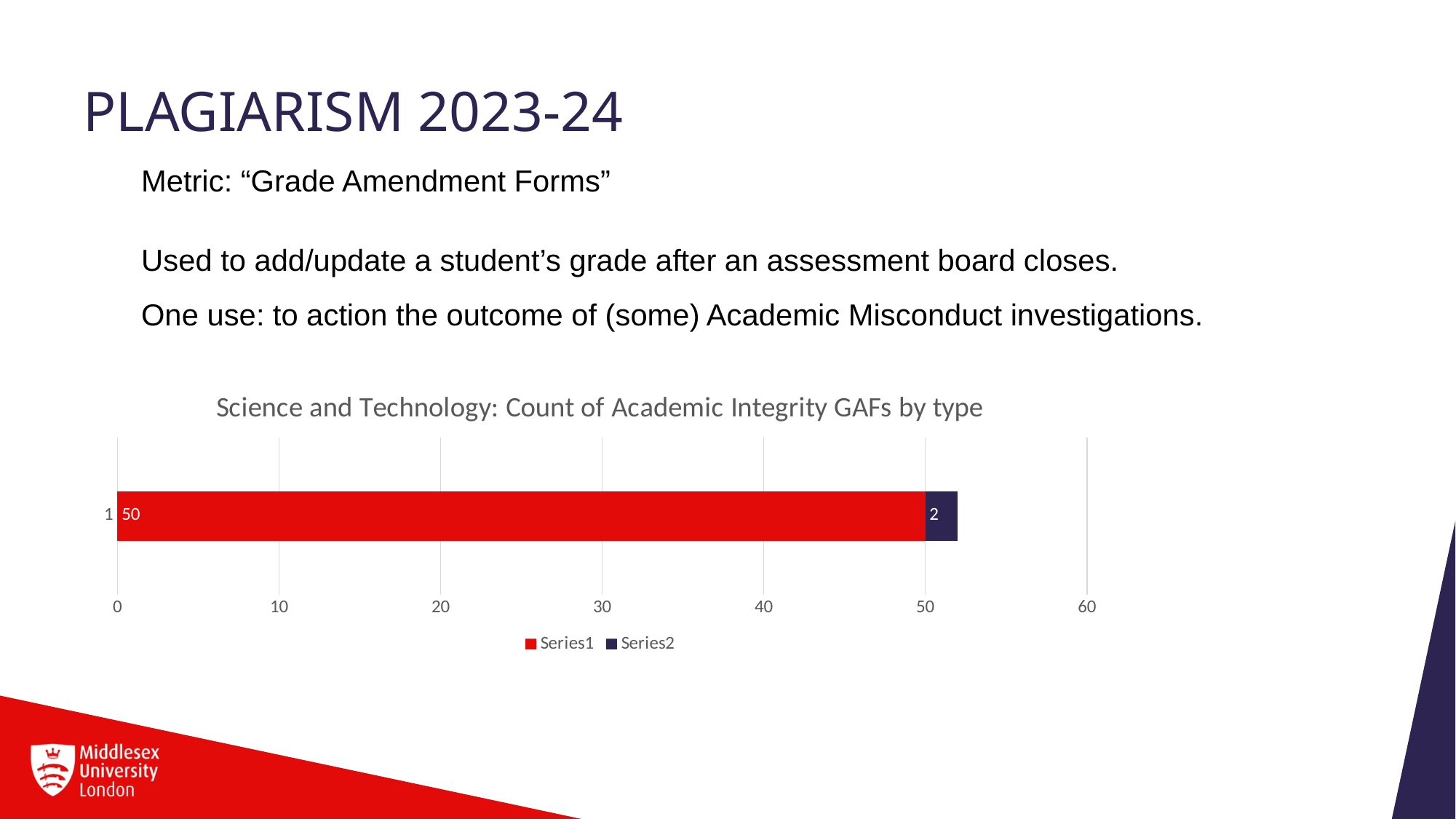
Is the total length of the stacked bar greater or less than 60? less What is the difference between the Series1 value and the Series2 value? 48 How many categories are shown on the chart? 1 What is the highest value shown on the x axis? 60 What colour represents Series1 in the chart? Red What is the value of Series1 in the chart? 50 What is the title of the chart? Science and Technology: Count of Academic Integrity GAFs by type Which series has the larger value, Series1 or Series2? Series1 What is the value of Series2 in the chart? 2 What kind of chart is shown on the slide? Stacked bar chart How many series does the legend list? 2 What is the total of the stacked bar for category 1? 52